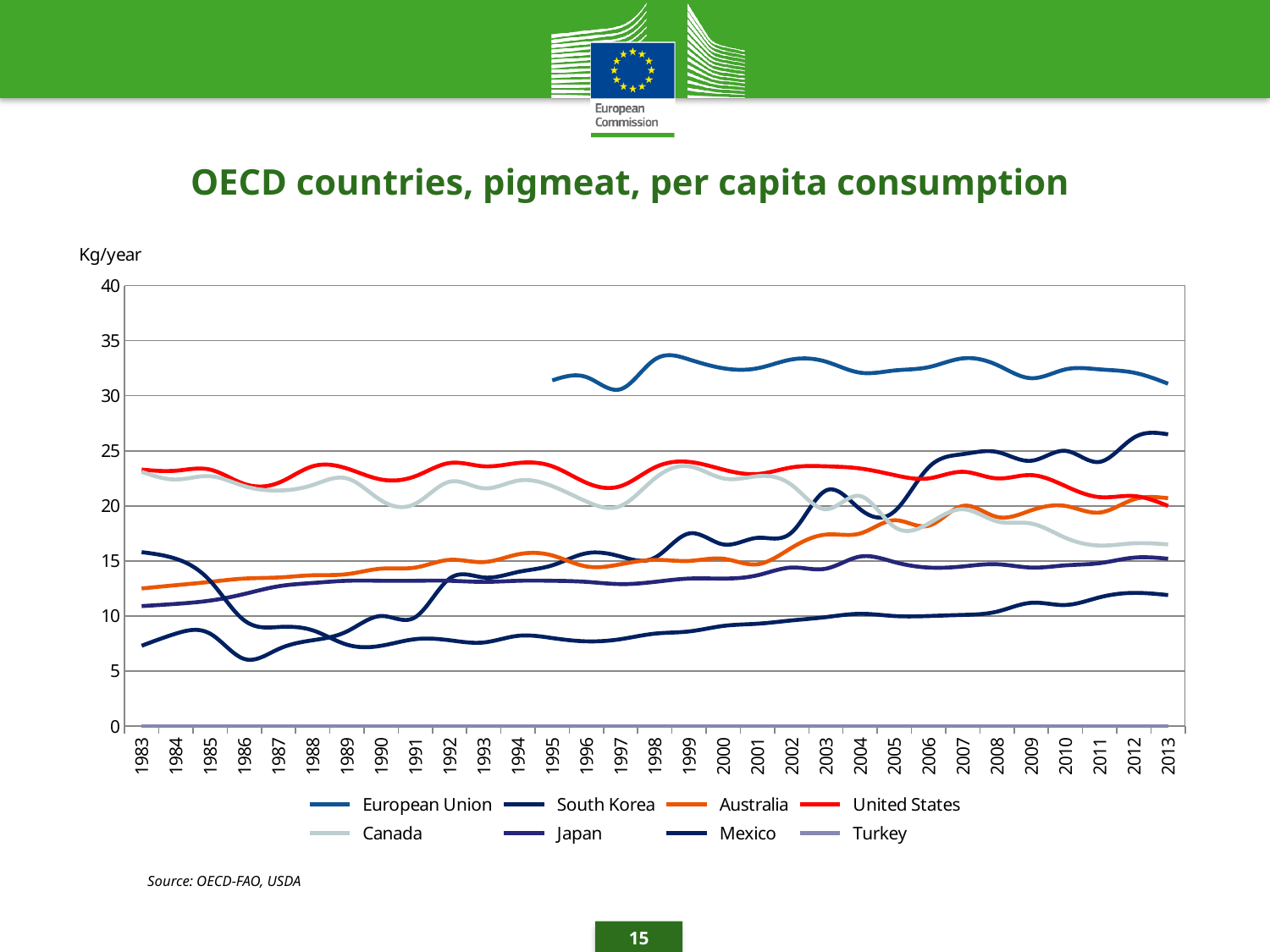
Is the value for the European Union in 2013 greater or less than 30? greater Which is larger in 2013, the value for South Korea or the value for Australia? South Korea Which series has the highest value in 2013? European Union What kind of chart is shown on the slide? Line chart What unit is shown on the y axis? Kg/year How many series does the legend list? 8 Is the value for South Korea in 1983 greater or less than 10? less Which series has the lowest value across the whole period? Turkey Is the value for Mexico in 2013 greater or less than 10? greater Does the value for South Korea rise or fall from 1983 to 2013? rise Which is larger in 2013, the value for Japan or the value for Mexico? Japan How many years are shown along the x axis? 31